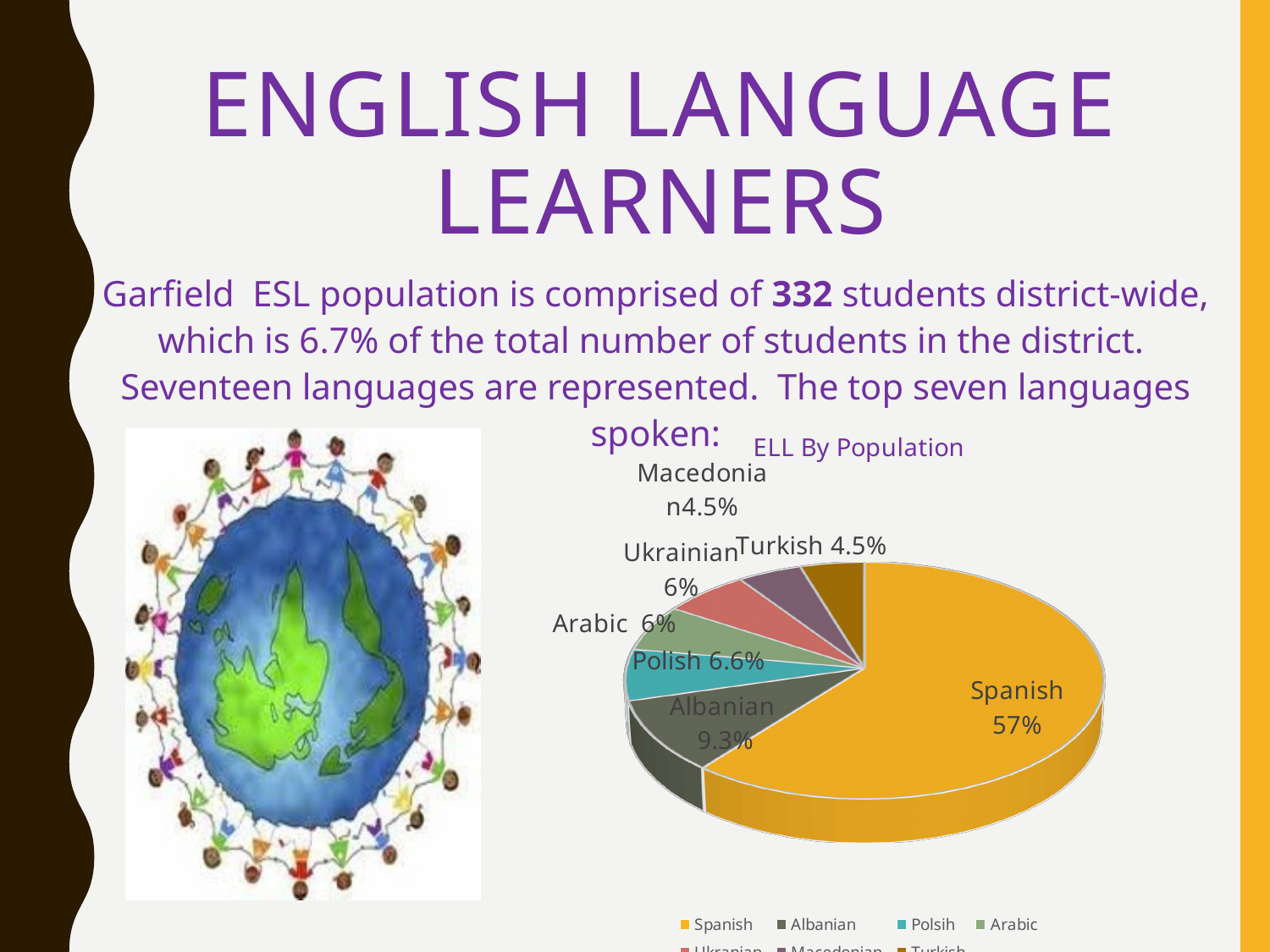
What kind of chart is shown on the slide? Pie chart What percentage of the ELL population speaks Turkish? 4.5% What percentage of the ELL population speaks Ukrainian? 6% What percentage of the ELL population speaks Spanish? 57% What percentage of the ELL population speaks Albanian? 9.3% What percentage of the ELL population speaks Polish? 6.6% Which has a larger share, Polish or Arabic? Polish How many percentage points larger is the Albanian share than the Polish share? 2.7 percentage points How many percentage points larger is the Spanish share than the Albanian share? 47.7 percentage points Which language has the largest share of the ELL population? Spanish How many language slices does the pie chart show? 7 What is the title of the chart? ELL By Population